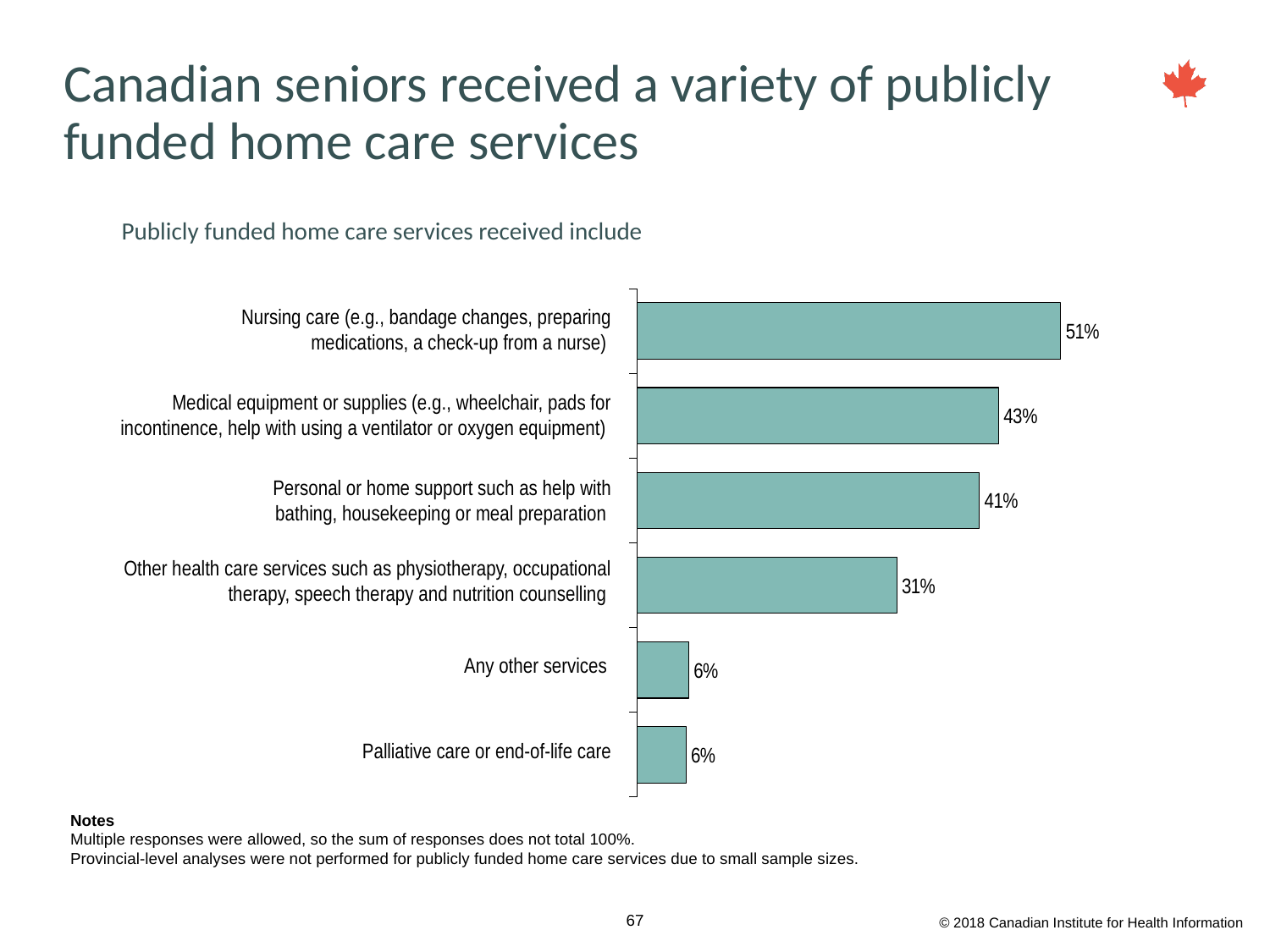
What is the difference between the values for personal or home support and other health care services? 10% Which is larger, the value for medical equipment or supplies or the value for other health care services? Medical equipment or supplies What percentage received personal or home support such as help with bathing, housekeeping or meal preparation? 41% What is the value for medical equipment or supplies? 43% What is the value for other health care services such as physiotherapy, occupational therapy, speech therapy and nutrition counselling? 31% What percentage received palliative care or end-of-life care? 6% What is the subtitle shown above the chart? Publicly funded home care services received include Which service category has the highest value? Nursing care What is the difference between the values for nursing care and medical equipment or supplies? 8% What kind of chart is shown on the slide? Bar chart What percentage of seniors received nursing care? 51% How many service categories are shown in the chart? 6